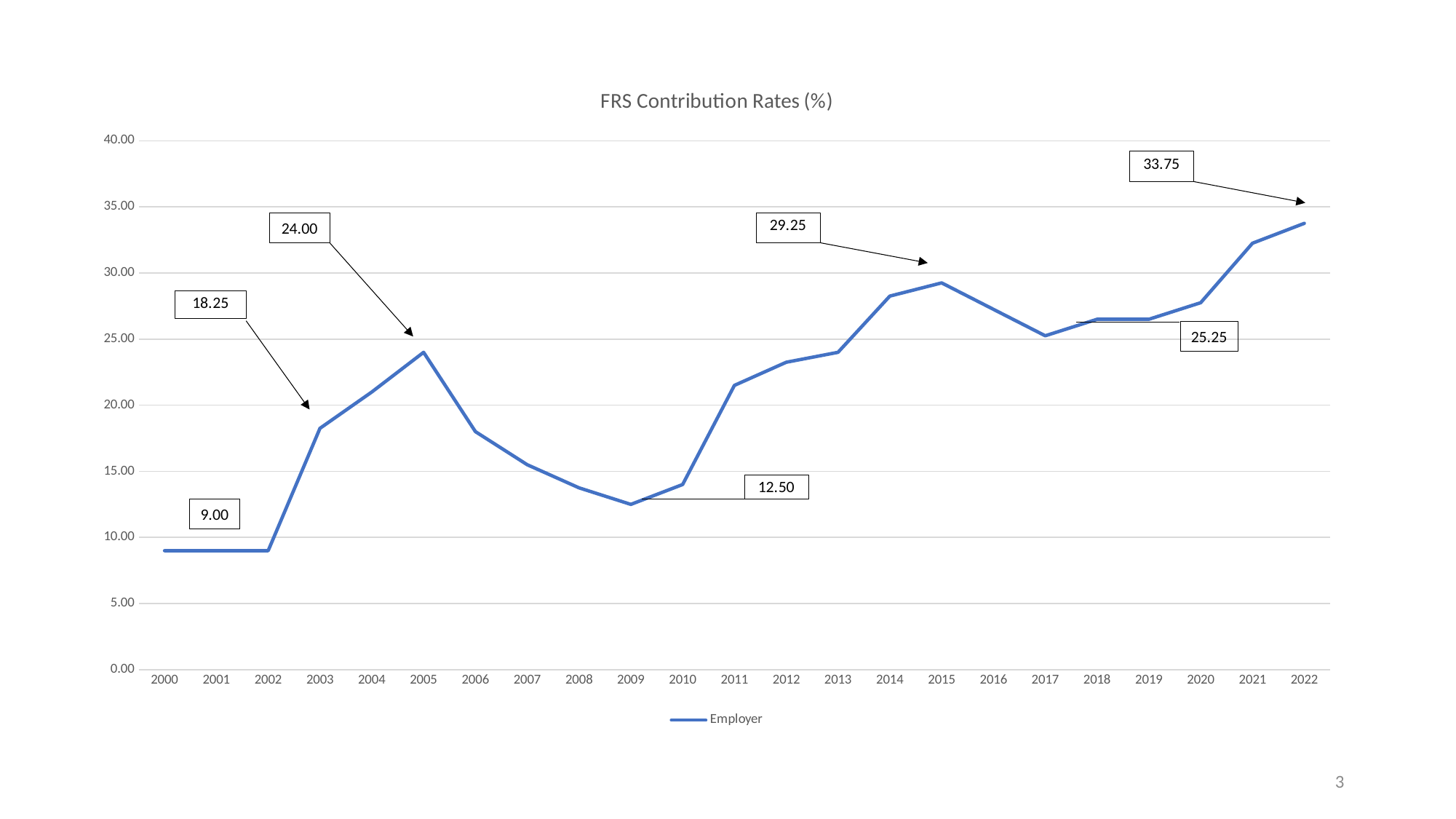
What is the Employer contribution rate in 2003? 18.25 Is the Employer contribution rate in 2014 greater or less than 25.00? greater How many years are shown on the x axis? 23 What is the Employer contribution rate in 2009? 12.50 What is the Employer contribution rate in 2022? 33.75 What type of chart is shown on the slide? line chart What is the difference between the Employer rate in 2022 and the rate in 2015? 4.50 What is the title of the chart? FRS Contribution Rates (%) What is the Employer contribution rate in 2005? 24.00 How many series does the legend list? 1 Which year has the highest Employer contribution rate? 2022 Which is larger, the Employer rate in 2005 or the rate in 2017? 2017